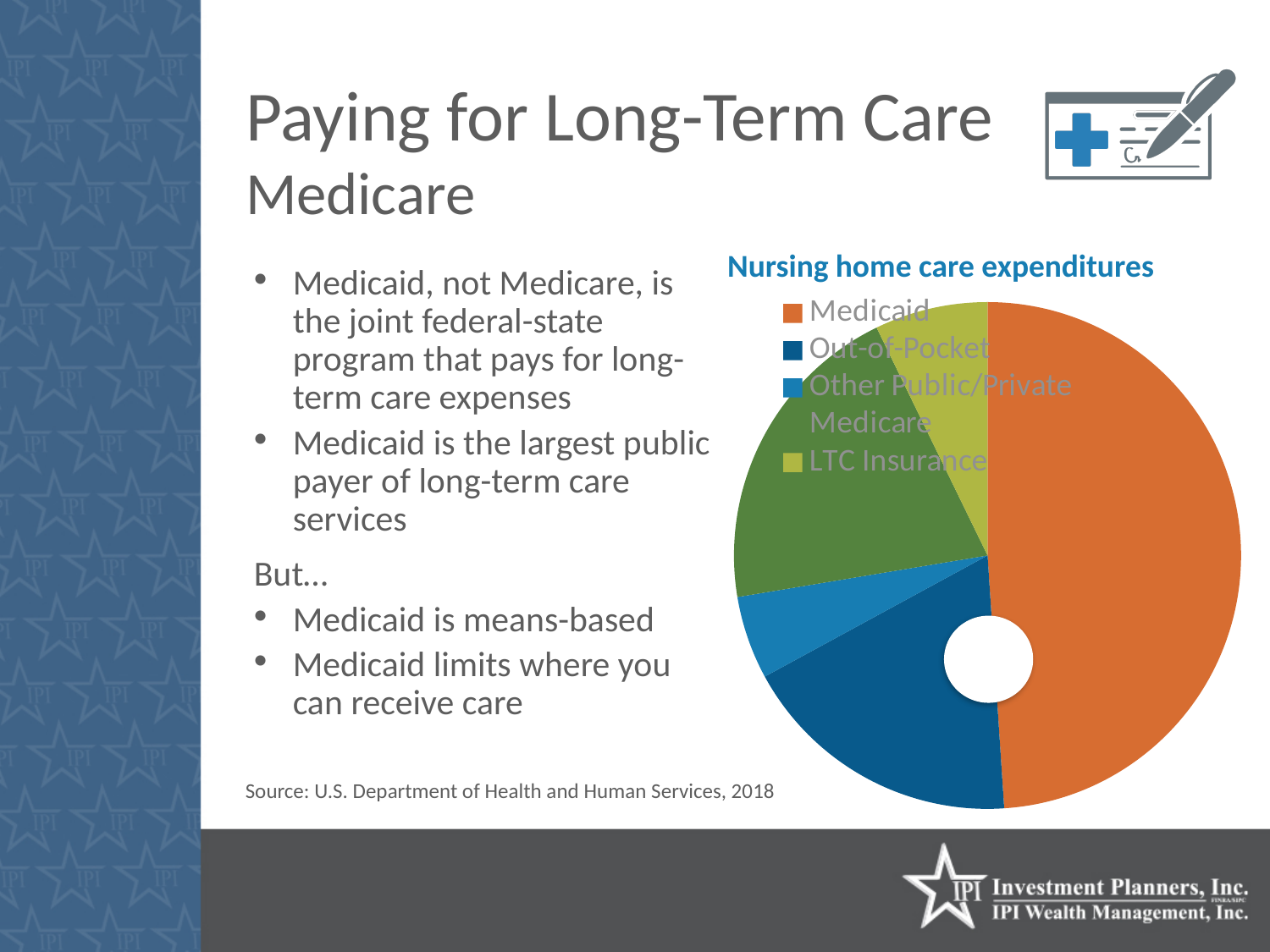
Which slice is larger, Medicare or LTC Insurance? Medicare Which slice is larger, Out-of-Pocket or Other Public/Private? Out-of-Pocket Which category has the largest slice of the pie chart? Medicaid Which slice is larger, Medicaid or Medicare? Medicaid What is the title of the chart on the slide? Nursing home care expenditures How many categories does the pie chart's legend list? 5 What kind of chart is shown on the slide? pie chart What colour is the Medicaid slice in the pie chart? orange